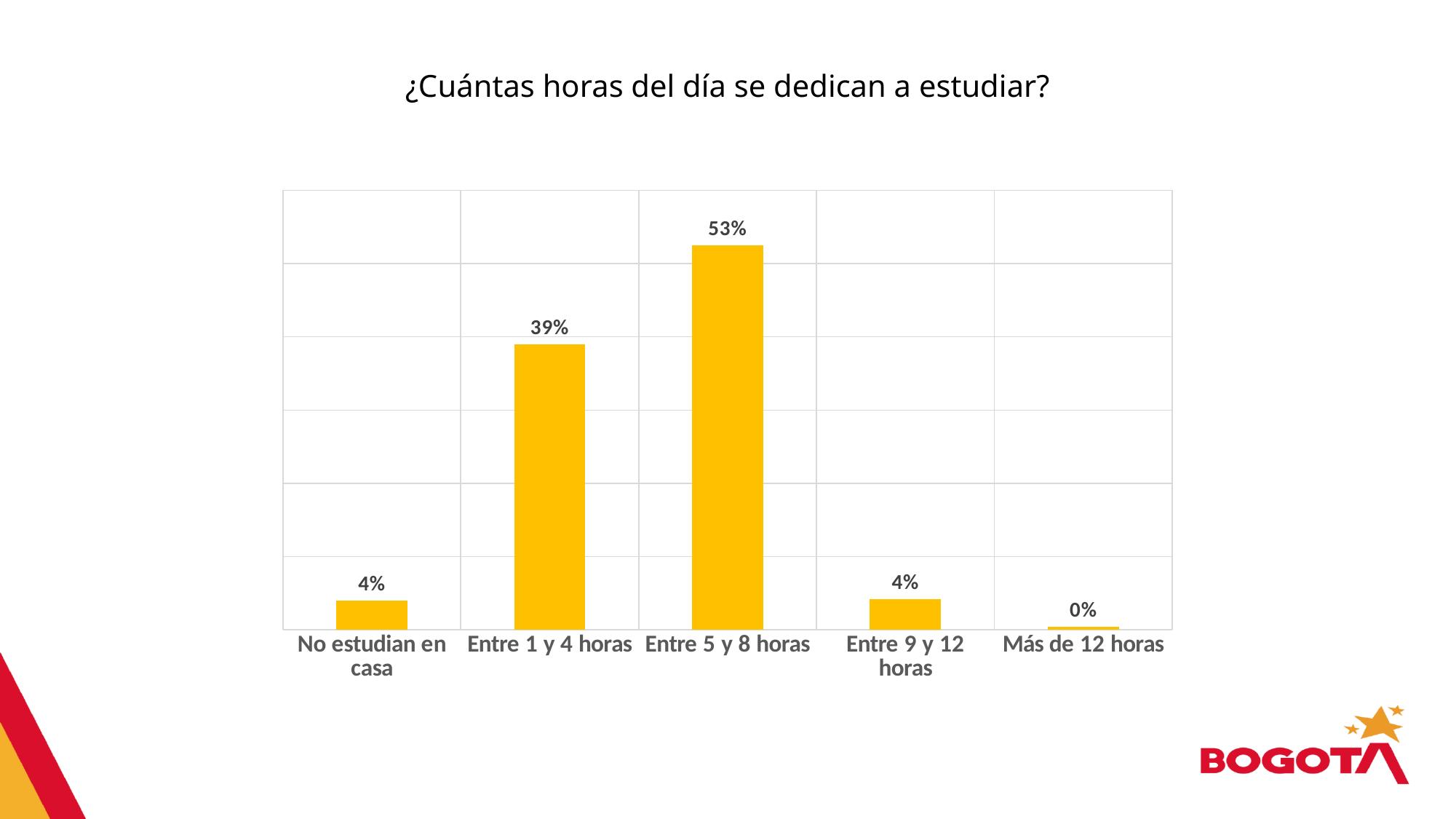
What kind of chart is shown on the slide? Bar chart What is the value for 'Entre 1 y 4 horas'? 39% Which category has the highest value? Entre 5 y 8 horas What colour are the bars in the chart? Yellow How many categories are shown on the x axis? 5 Which is larger, the value for 'Entre 1 y 4 horas' or the value for 'Entre 9 y 12 horas'? Entre 1 y 4 horas What is the value for 'Más de 12 horas'? 0% What is the value for 'No estudian en casa'? 4% What is the value for 'Entre 5 y 8 horas'? 53% What is the title of the chart? ¿Cuántas horas del día se dedican a estudiar? Which category has the lowest value? Más de 12 horas What is the difference between the values for 'Entre 5 y 8 horas' and 'Entre 1 y 4 horas'? 14%